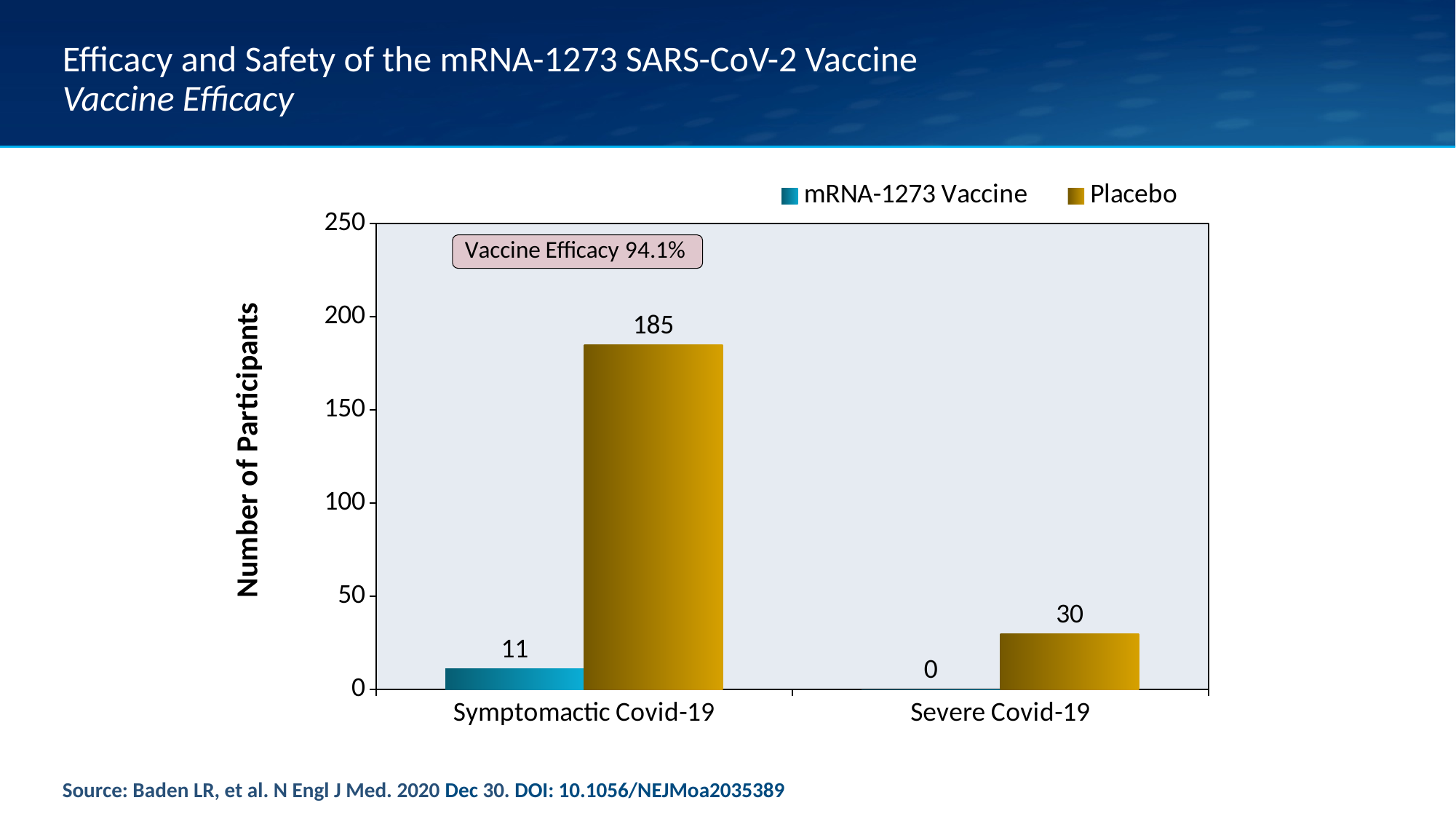
How many categories are shown on the x axis? 2 What is the number of participants with Severe Covid-19 in the mRNA-1273 Vaccine group? 0 What is the number of participants with Symptomactic Covid-19 in the mRNA-1273 Vaccine group? 11 How many series does the legend list? 2 What is the difference between the Placebo values for Symptomactic Covid-19 and Severe Covid-19? 155 What is the number of participants with Symptomactic Covid-19 in the Placebo group? 185 What is the difference between the Placebo and mRNA-1273 Vaccine values for Symptomactic Covid-19? 174 What vaccine efficacy is stated in the box on the chart? 94.1% Is the Placebo value for Symptomactic Covid-19 greater or less than 150? greater Which bar on the chart has the highest value? Placebo, Symptomactic Covid-19 What is the number of participants with Severe Covid-19 in the Placebo group? 30 Which is larger for Severe Covid-19: the mRNA-1273 Vaccine value or the Placebo value? Placebo